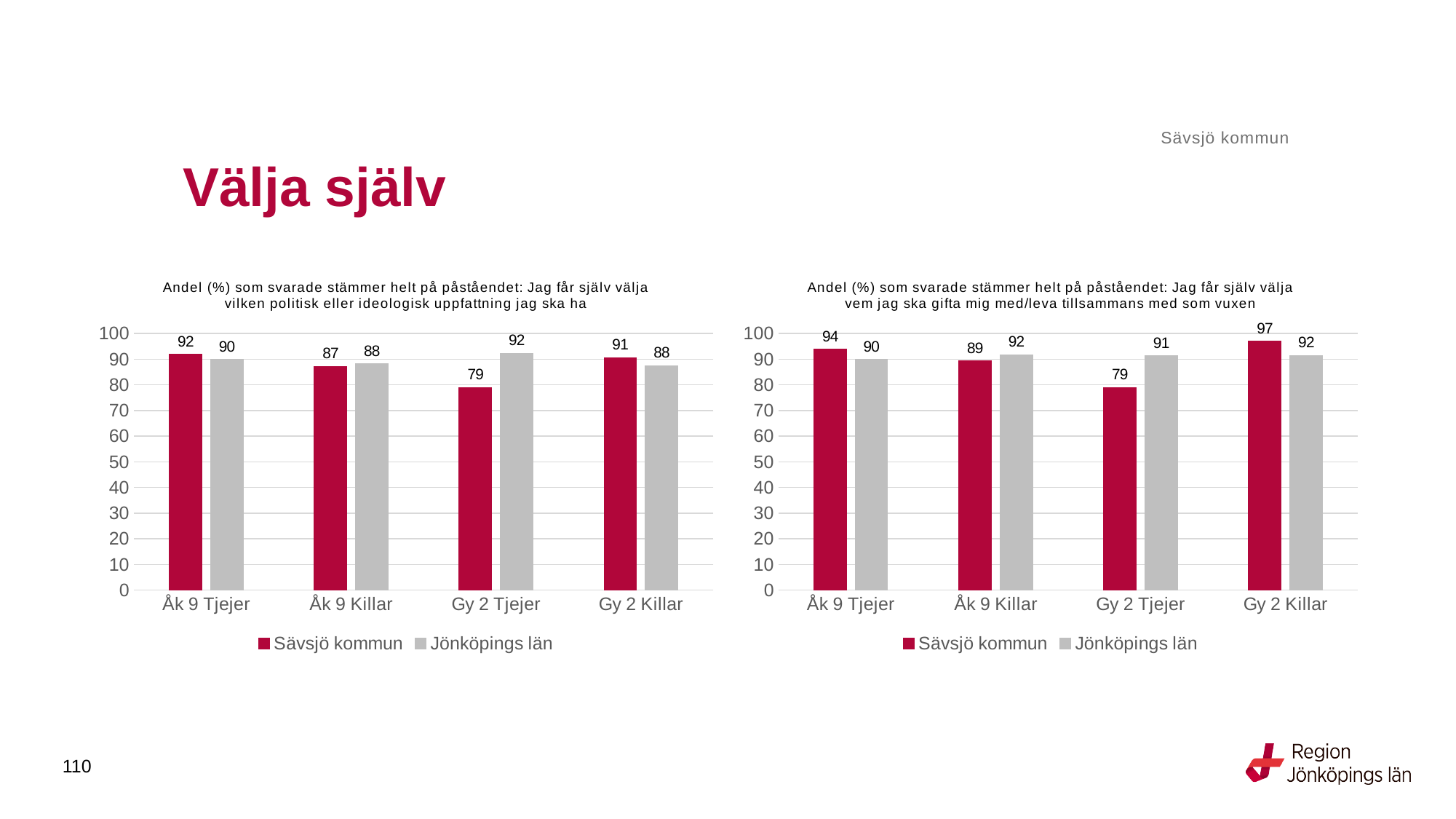
What kind of chart is the left chart? bar chart In the right chart, which is larger for Åk 9 Tjejer: Sävsjö kommun or Jönköpings län? Sävsjö kommun In the right chart, what is the difference between Sävsjö kommun and Jönköpings län for Gy 2 Killar? 5 How many categories are shown on the x axis of the left chart? 4 In the left chart, what is the value for Sävsjö kommun for Gy 2 Tjejer? 79 How many series does the legend of the right chart list? 2 In the right chart, what is the value for Jönköpings län for Åk 9 Killar? 92 In the left chart, what is the difference between Jönköpings län and Sävsjö kommun for Gy 2 Tjejer? 13 In the left chart, which category has the lowest value for Sävsjö kommun? Gy 2 Tjejer In the right chart, which category has the highest value for Sävsjö kommun? Gy 2 Killar In the left chart, is the value for Sävsjö kommun for Gy 2 Tjejer greater or less than 80? less In the right chart, which series is shown in grey? Jönköpings län